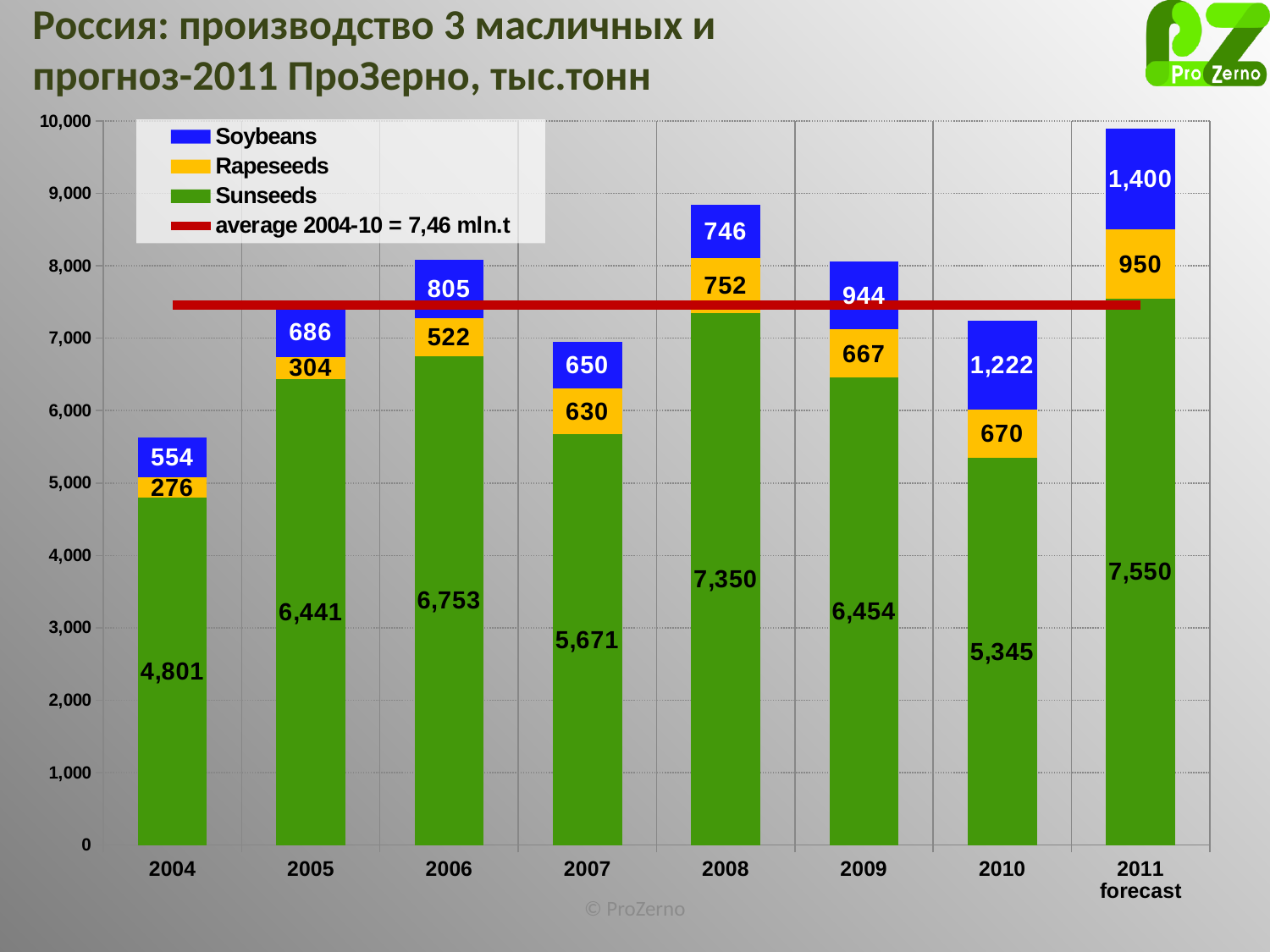
What is the Rapeseeds value for 2006? 522 What kind of chart is shown on the slide? Stacked bar chart What is the Sunseeds value for 2008? 7,350 What is the difference between the Sunseeds values for 2008 and 2007? 1,679 What is the Soybeans value for 2010? 1,222 In which year is the Rapeseeds value lowest? 2004 In which year is the Sunseeds value highest? 2011 forecast In 2009, which is larger: the Soybeans value or the Rapeseeds value? Soybeans What value does the legend give for the average 2004-10 line? 7,46 mln.t How many entries does the legend list? 4 What is the total of the stacked bar for 2004? 5,631 How many years (categories) are shown on the x axis? 8